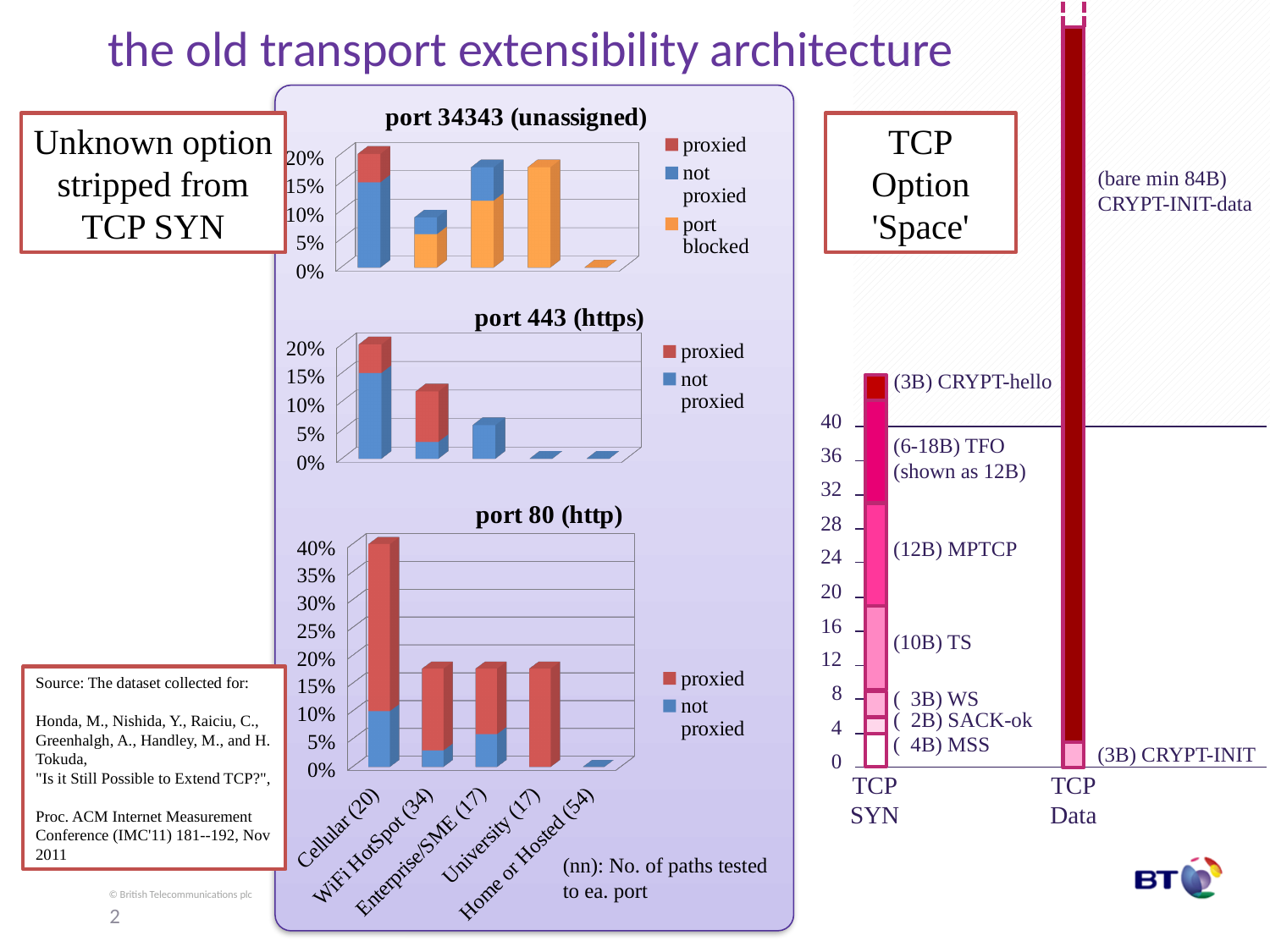
How many series does the legend of the "port 34343 (unassigned)" chart list? 3 How many categories are shown on the x axis of the "port 80 (http)" chart? 5 In the "port 443 (https)" chart, which category has the highest total bar? Cellular (20) What kind of chart is the "port 80 (http)" chart? bar chart In the "port 80 (http)" chart, is the total value for WiFi HotSpot (34) greater or less than 20%? less In the "port 80 (http)" chart, is the total value for Cellular (20) greater or less than 30%? greater How many series does the legend of the "port 443 (https)" chart list? 2 In the "port 80 (http)" chart, which has the larger total bar, Cellular (20) or WiFi HotSpot (34)? Cellular (20) In the "port 34343 (unassigned)" chart, which legend series is shown in orange? port blocked In the "port 80 (http)" chart, which category has the highest total bar? Cellular (20) In the "port 80 (http)" chart, which category has the lowest total bar? Home or Hosted (54) In the "port 443 (https)" chart, is the total value for Cellular (20) greater or less than 15%? greater